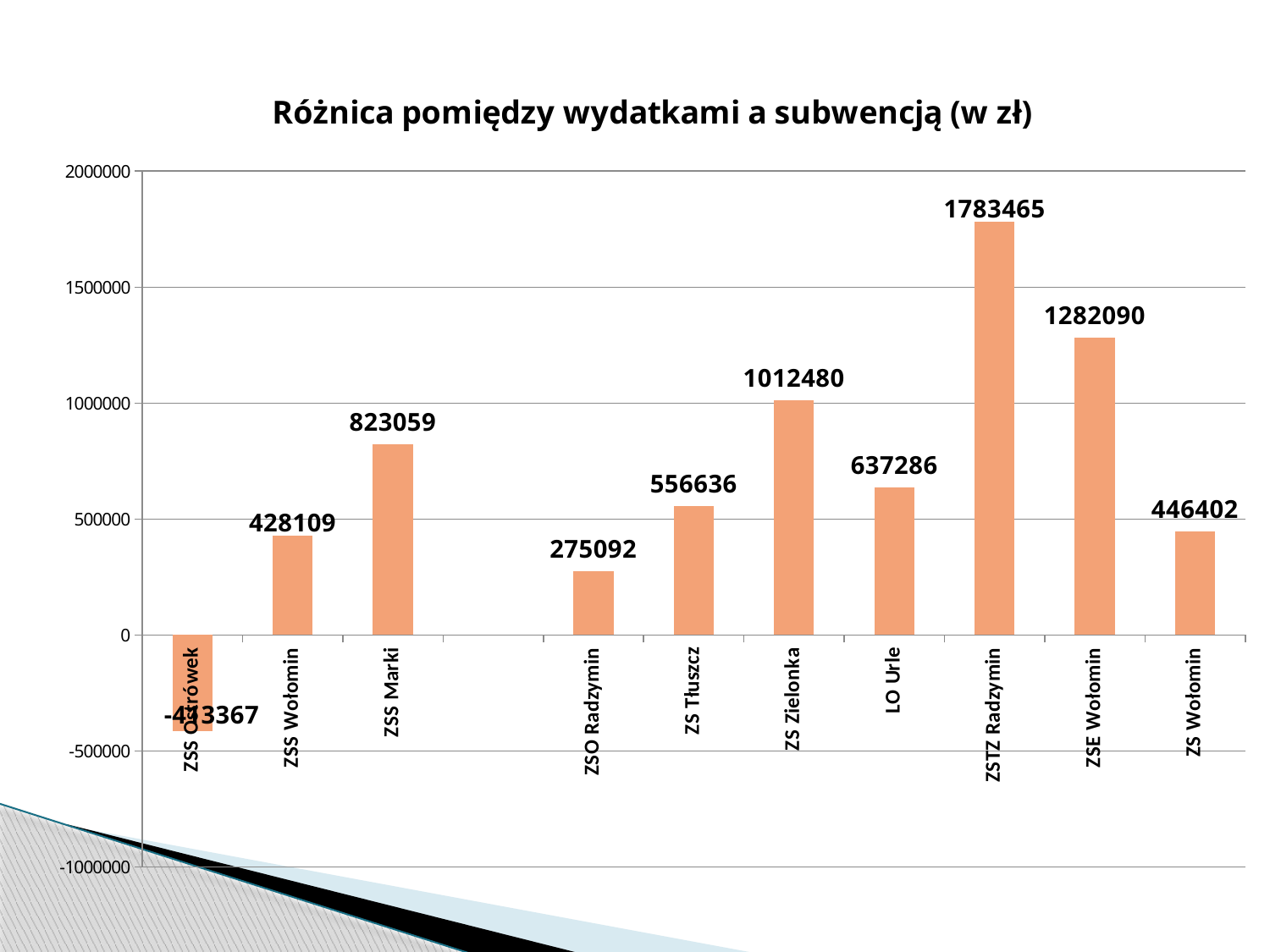
What is the difference between the values for ZSS Marki and ZSS Wołomin? 394950 What is the value for ZSTZ Radzymin? 1783465 What is the value for LO Urle? 637286 What is the value for ZSO Radzymin? 275092 Which category has the lowest value? ZSS Ostrówek What is the difference between the values for ZSTZ Radzymin and ZSE Wołomin? 501375 Which category has the highest value? ZSTZ Radzymin Is the value for ZSS Ostrówek greater or less than 0? less Which is larger, the value for ZS Tłuszcz or the value for LO Urle? LO Urle What type of chart is shown on the slide? bar chart What is the value for ZS Wołomin? 446402 How many bars are plotted in the chart? 10